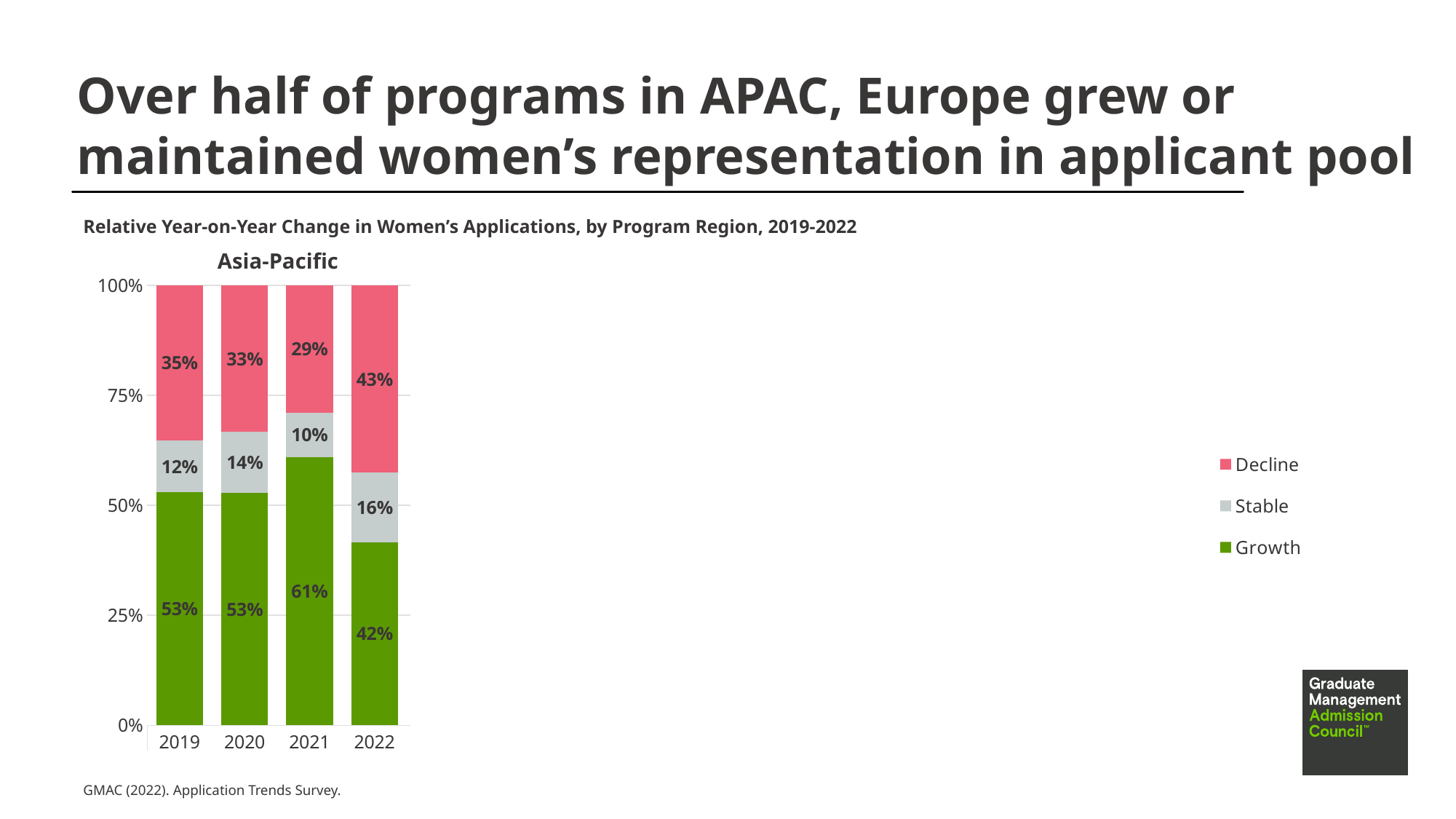
Which colour represents the Decline series in the legend? pink What is the total of the stacked bar for 2020 in the Asia-Pacific chart? 100% How many series does the legend list? 3 How many years are shown on the x axis of the Asia-Pacific chart? 4 Is the Growth value for 2019 larger or smaller than the Growth value for 2022? larger What is the difference between the Decline values for 2022 and 2021 in the Asia-Pacific chart? 14% What is the Stable value for 2020 in the Asia-Pacific chart? 14% What kind of chart is shown on the slide? stacked bar chart What is the Growth value for 2021 in the Asia-Pacific chart? 61% Which year has the highest Growth value in the Asia-Pacific chart? 2021 What is the Decline value for 2022 in the Asia-Pacific chart? 43% Which year has the lowest Stable value in the Asia-Pacific chart? 2021